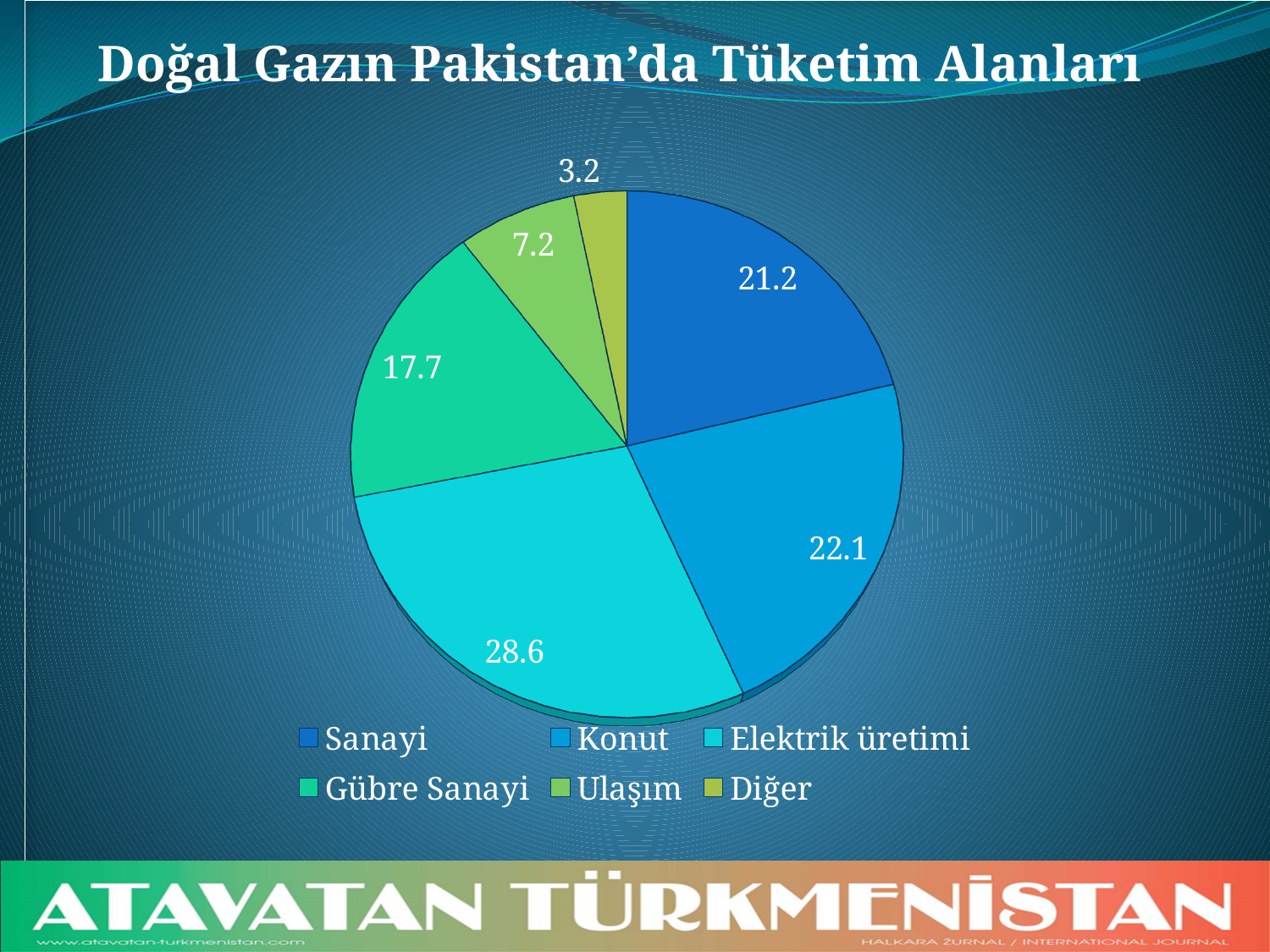
Which is larger, the value for Konut or the value for Gübre Sanayi? Konut What is the title of the chart on the slide? Doğal Gazın Pakistan'da Tüketim Alanları How many categories does the pie chart show? 6 What is the value for Elektrik üretimi in the pie chart? 28.6 What kind of chart is shown on the slide? Pie chart Which category has the largest slice of the pie chart? Elektrik üretimi Which category has the smallest slice of the pie chart? Diğer What is the value for Sanayi in the pie chart? 21.2 What is the value for Gübre Sanayi in the pie chart? 17.7 What is the difference between the values for Elektrik üretimi and Konut? 6.5 What is the difference between the values for Ulaşım and Diğer? 4 What is the value for Diğer in the pie chart? 3.2